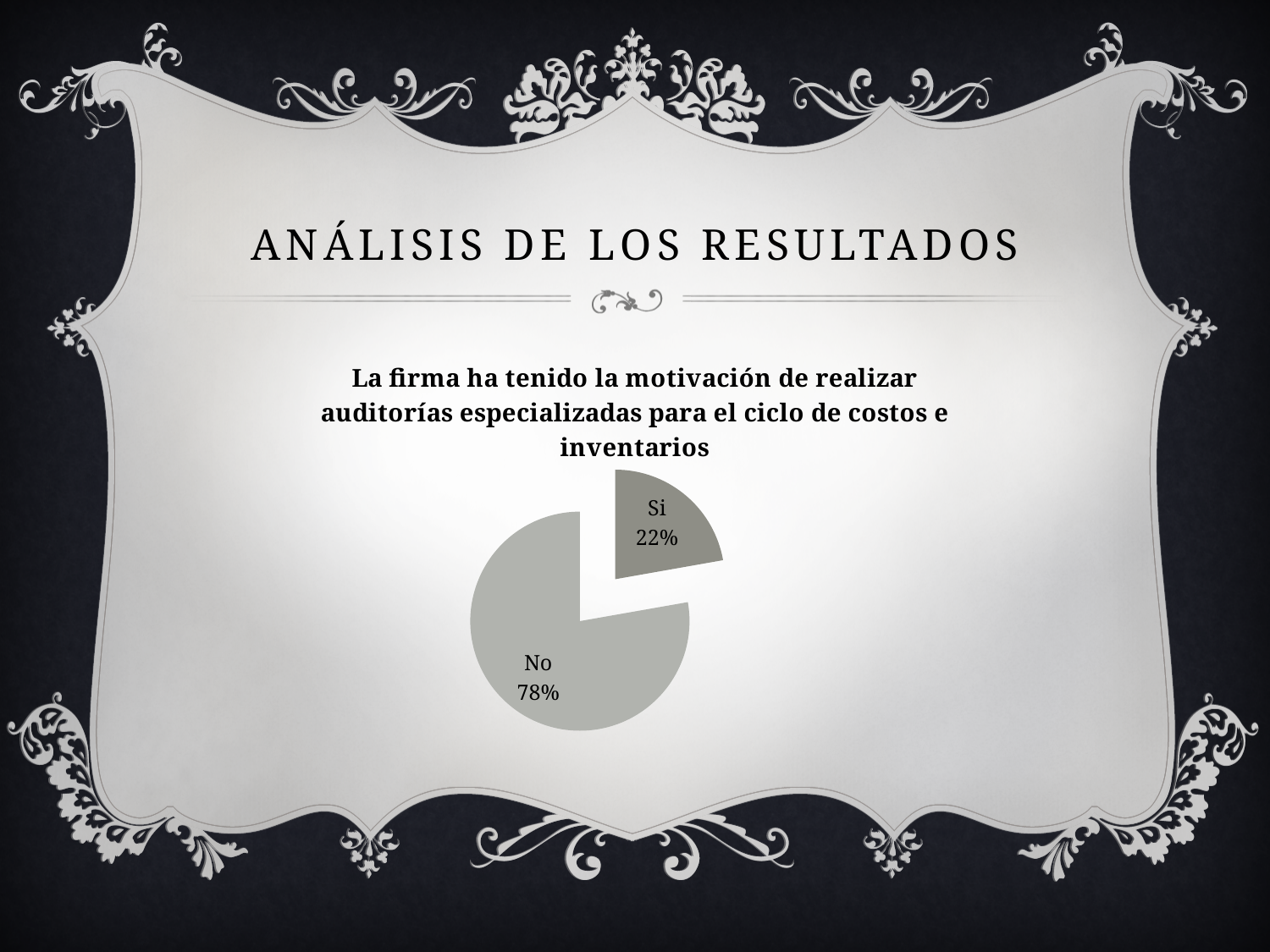
What is the title of the chart? La firma ha tenido la motivación de realizar auditorías especializadas para el ciclo de costos e inventarios What percentage of the pie chart is labelled "No"? 78% Which slice of the pie chart is the largest? No What share of the pie does the "Si" slice represent? 22% Which slice is larger, "Si" or "No"? No How many slices does the pie chart have? 2 What percentage of the pie chart is labelled "Si"? 22% What kind of chart is shown on the slide? Pie chart Which slice of the pie chart is the smallest? Si What is the difference in percentage points between the "No" slice and the "Si" slice? 56 Is the "No" slice greater or less than 50% of the pie? greater